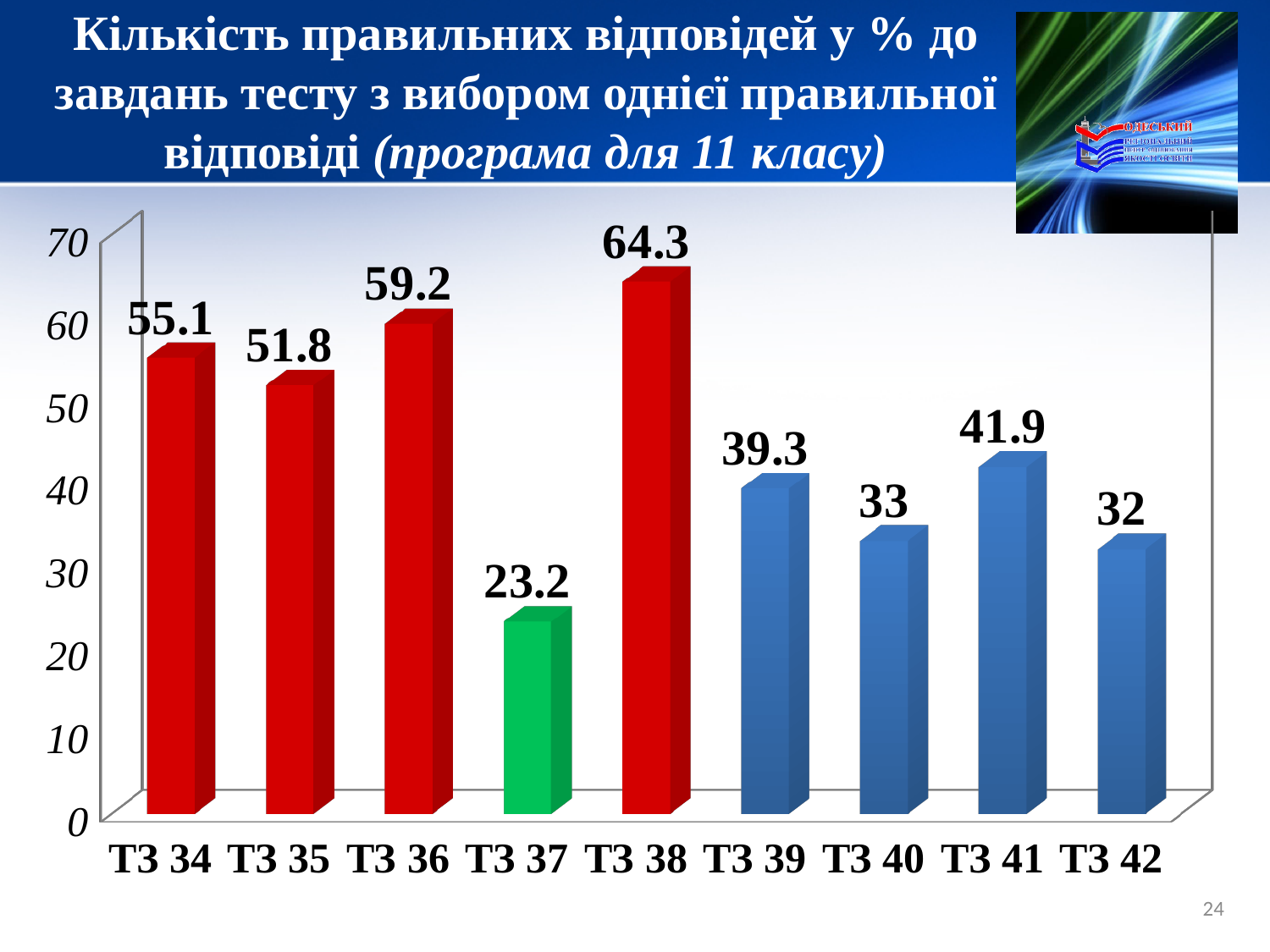
What colour is the bar for ТЗ 37? green Which category has the highest value? ТЗ 38 How many categories are shown on the x axis? 9 Is the value for ТЗ 34 greater or less than 50? greater Which is larger, the value for ТЗ 39 or the value for ТЗ 40? ТЗ 39 What is the difference between the values for ТЗ 36 and ТЗ 35? 7.4 What is the value for ТЗ 38? 64.3 Which category has the lowest value? ТЗ 37 What is the difference between the values for ТЗ 38 and ТЗ 37? 41.1 What kind of chart is shown on the slide? bar chart What is the value for ТЗ 41? 41.9 What is the value for ТЗ 37? 23.2